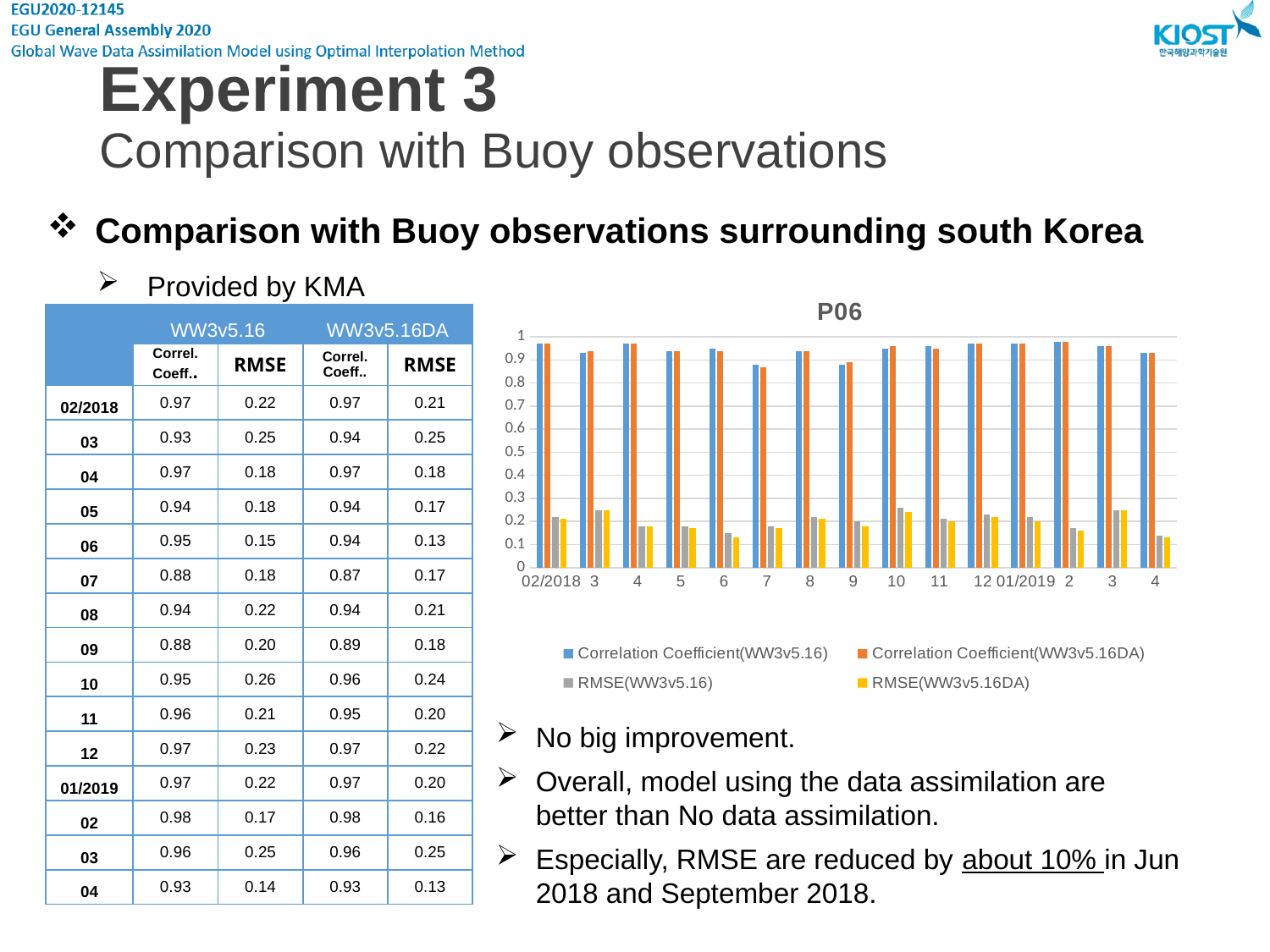
In the P06 chart, is the RMSE(WW3v5.16) value for month 10 greater or less than 0.2? greater In the P06 chart, is the RMSE(WW3v5.16DA) value for month 6 greater or less than 0.2? less What is the title of the chart on the slide? P06 According to the slide, what is the RMSE(WW3v5.16DA) value for month 10 of 2018? 0.24 In the P06 chart, which is larger: the RMSE(WW3v5.16) for month 10 or for month 6? month 10 How many categories (months) are shown along the x axis of the P06 chart? 15 Which series is shown in blue in the P06 chart? Correlation Coefficient(WW3v5.16) How many series does the legend of the P06 chart list? 4 According to the slide, what is the Correlation Coefficient(WW3v5.16) value for month 07 of 2018? 0.88 In the P06 chart, which is larger: the Correlation Coefficient(WW3v5.16) for 02/2018 or for month 7? 02/2018 What kind of chart is shown on the slide? bar chart In the P06 chart, is the Correlation Coefficient(WW3v5.16) value for month 7 greater or less than 0.9? less